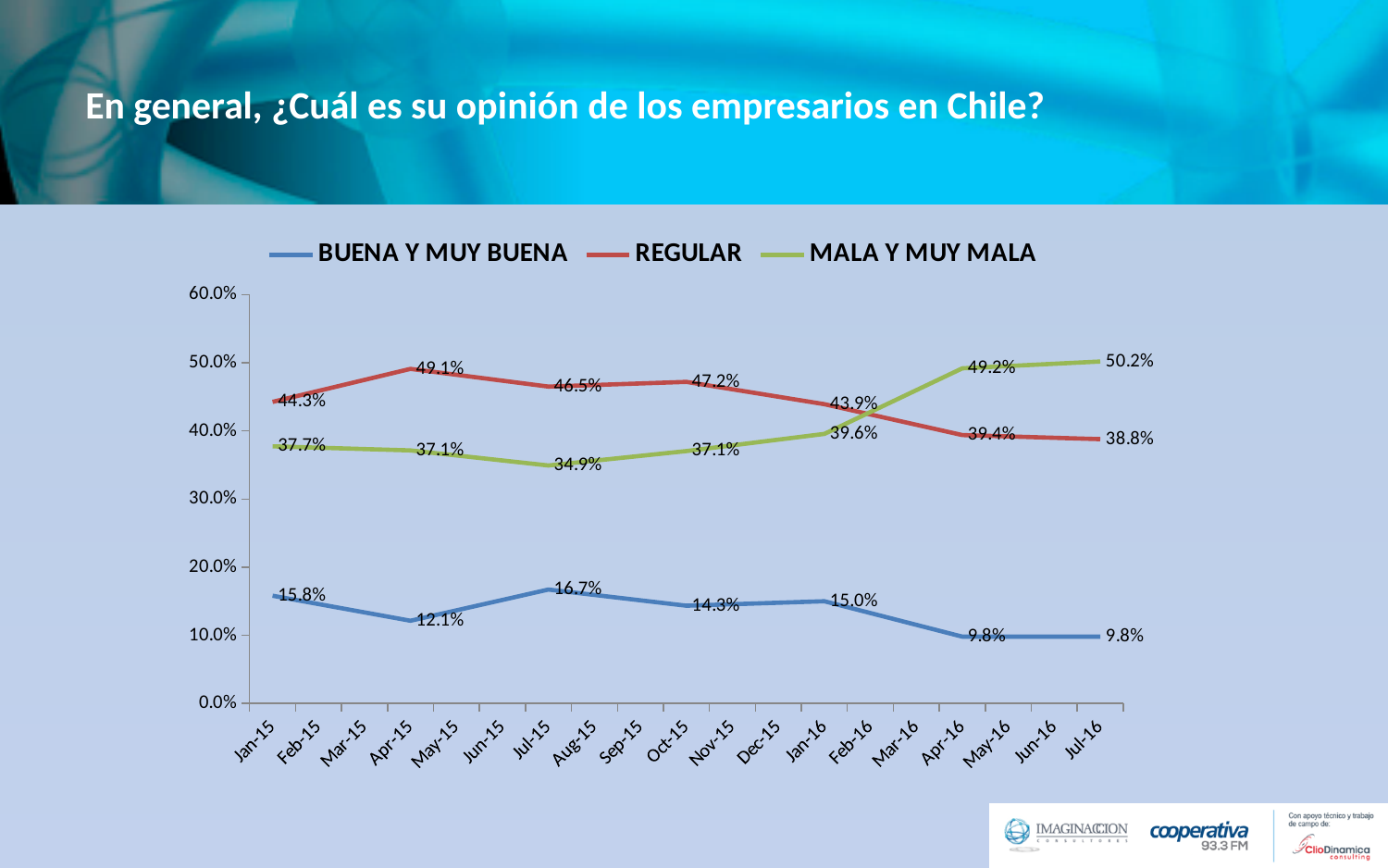
What is the difference between the MALA Y MUY MALA value in Jul-16 and in Jan-15? 12.5% What colour is the line for MALA Y MUY MALA? green How many labelled data points does the REGULAR series have? 7 In which month does the MALA Y MUY MALA series reach its lowest value? Jul-15 What is the value for REGULAR in Apr-15? 49.1% Does the BUENA Y MUY BUENA series rise or fall between Jan-16 and Apr-16? fall What type of chart is shown on the slide? line chart In which month does the REGULAR series reach its highest value? Apr-15 How many series does the legend list? 3 What is the value for BUENA Y MUY BUENA in Jul-15? 16.7% Which is larger in Jul-16: the REGULAR value or the MALA Y MUY MALA value? MALA Y MUY MALA What is the value for MALA Y MUY MALA in Jul-16? 50.2%